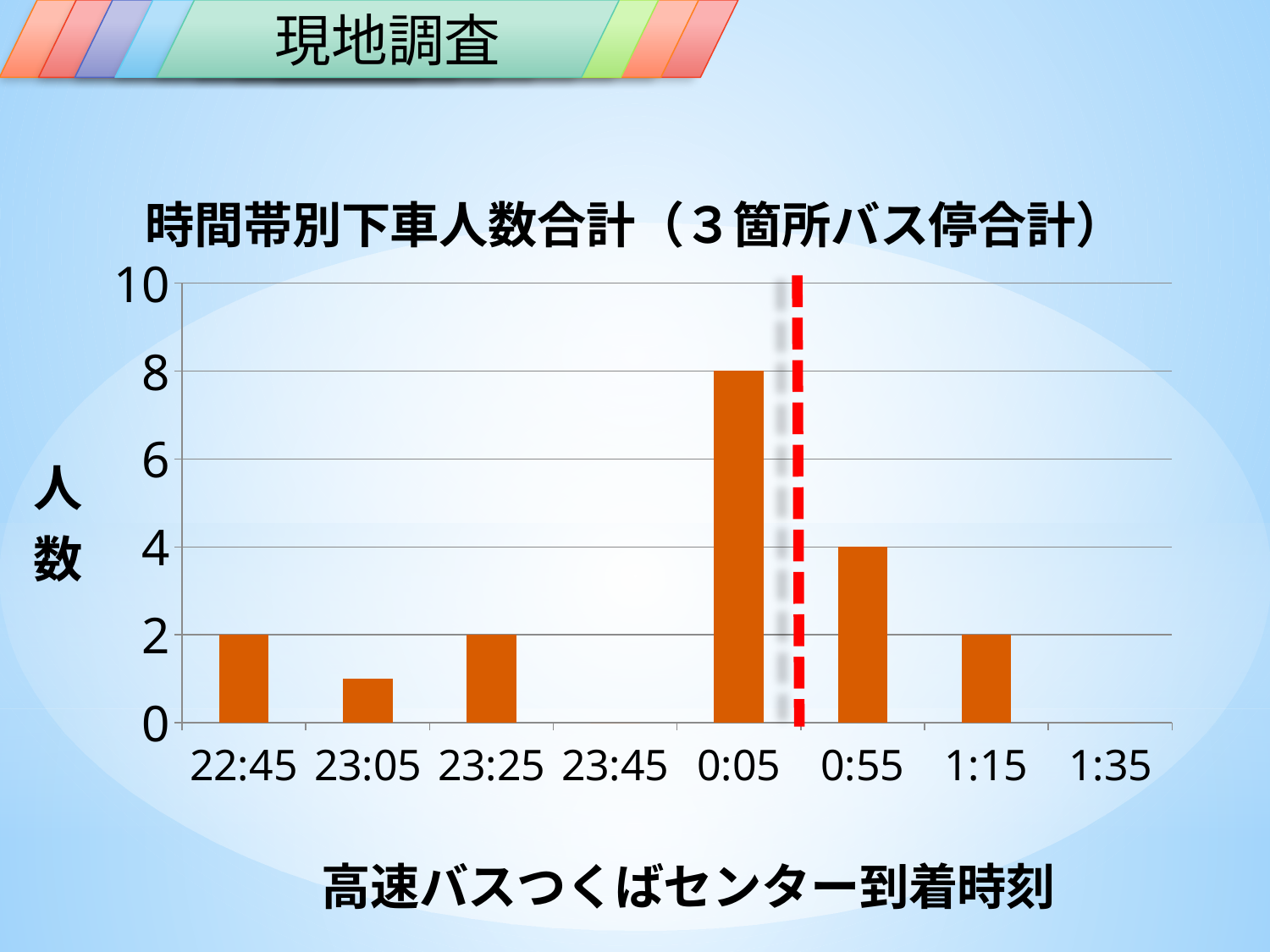
What kind of chart is shown on the slide? bar chart What is the title of the chart? 時間帯別下車人数合計（３箇所バス停合計） What is the value for 1:15 in the chart? 2 Is the value for 23:05 greater or less than 2? less How many time-slot categories are shown on the x axis? 8 Which time slot has the highest value? 0:05 What is the difference between the values for 0:05 and 0:55? 4 What is the value for 22:45 in the chart? 2 What is the label on the vertical axis of the chart? 人数 What is the value for 0:55 in the chart? 4 Which is larger, the value for 0:55 or the value for 1:15? 0:55 What is the value for 0:05 in the chart? 8